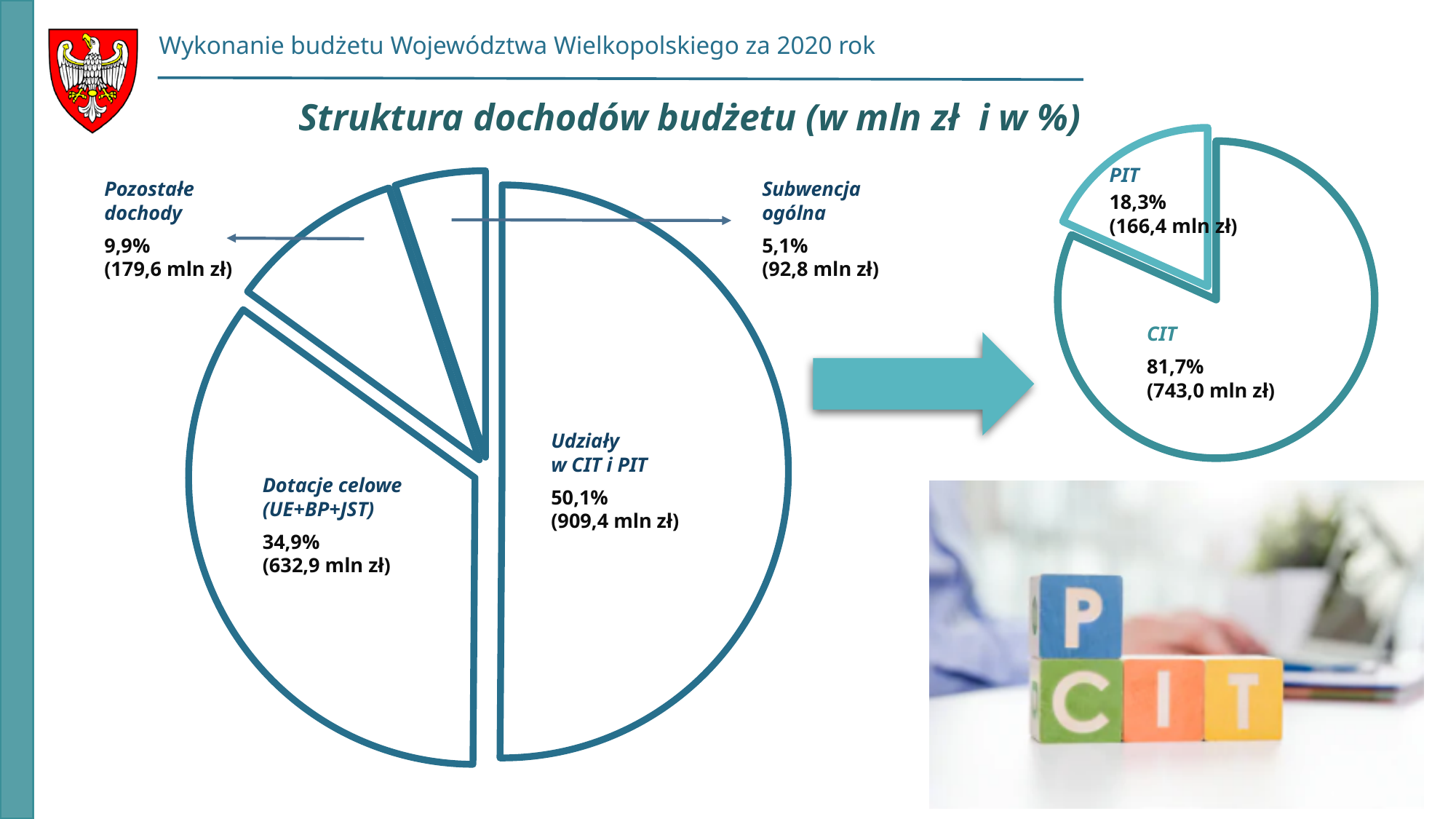
In the large pie chart on the left, what is the value in mln zł for Dotacje celowe (UE+BP+JST)? 632,9 mln zł In the large pie chart on the left, which category has the largest share? Udziały w CIT i PIT In the large pie chart on the left, what is the difference in mln zł between Udziały w CIT i PIT and Dotacje celowe (UE+BP+JST)? 276,5 mln zł In the large pie chart on the left, what percentage share does Pozostałe dochody have? 9,9% What type of chart is used on the left side of the slide? Pie chart In the small pie chart on the right, what share does PIT have? 18,3% In the large pie chart on the left, what is the value in mln zł for Subwencja ogólna? 92,8 mln zł In the large pie chart on the left, how many slices are there? 4 In the small pie chart on the right, what is the value in mln zł for CIT? 743,0 mln zł In the small pie chart on the right, which is larger, CIT or PIT? CIT In the large pie chart on the left, which category has the smallest share? Subwencja ogólna In the large pie chart on the left, what share of budget revenue comes from Udziały w CIT i PIT? 50,1%